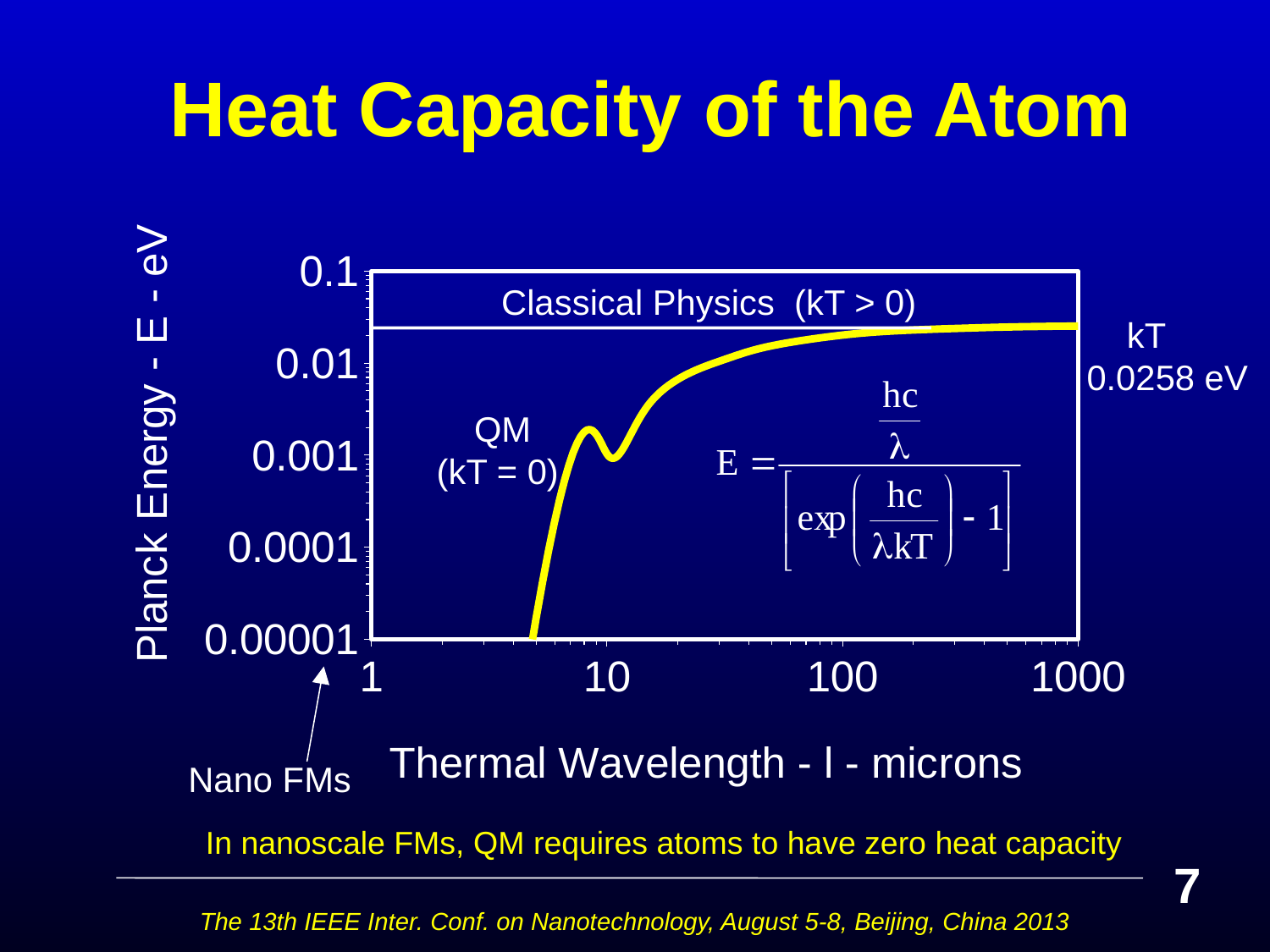
Is the Planck energy at a thermal wavelength of 1000 microns greater or less than 0.1 eV? less What value of kT is printed next to the chart? 0.0258 eV Does the Planck energy rise or fall as the thermal wavelength increases along the x axis? rise How many curves are plotted on the chart? 1 What is the highest tick value shown on the x axis? 1000 Is the Planck energy at a thermal wavelength of 100 microns greater or less than 0.01 eV? greater What is the title of the slide's chart? Heat Capacity of the Atom What kind of chart is shown on the slide? line chart Which region of the chart is labelled 'Classical Physics (kT > 0)': the upper or the lower part? upper What is the lowest tick value shown on the y axis? 0.00001 Is the Planck energy at a thermal wavelength of 1000 microns greater or less than 0.01 eV? greater